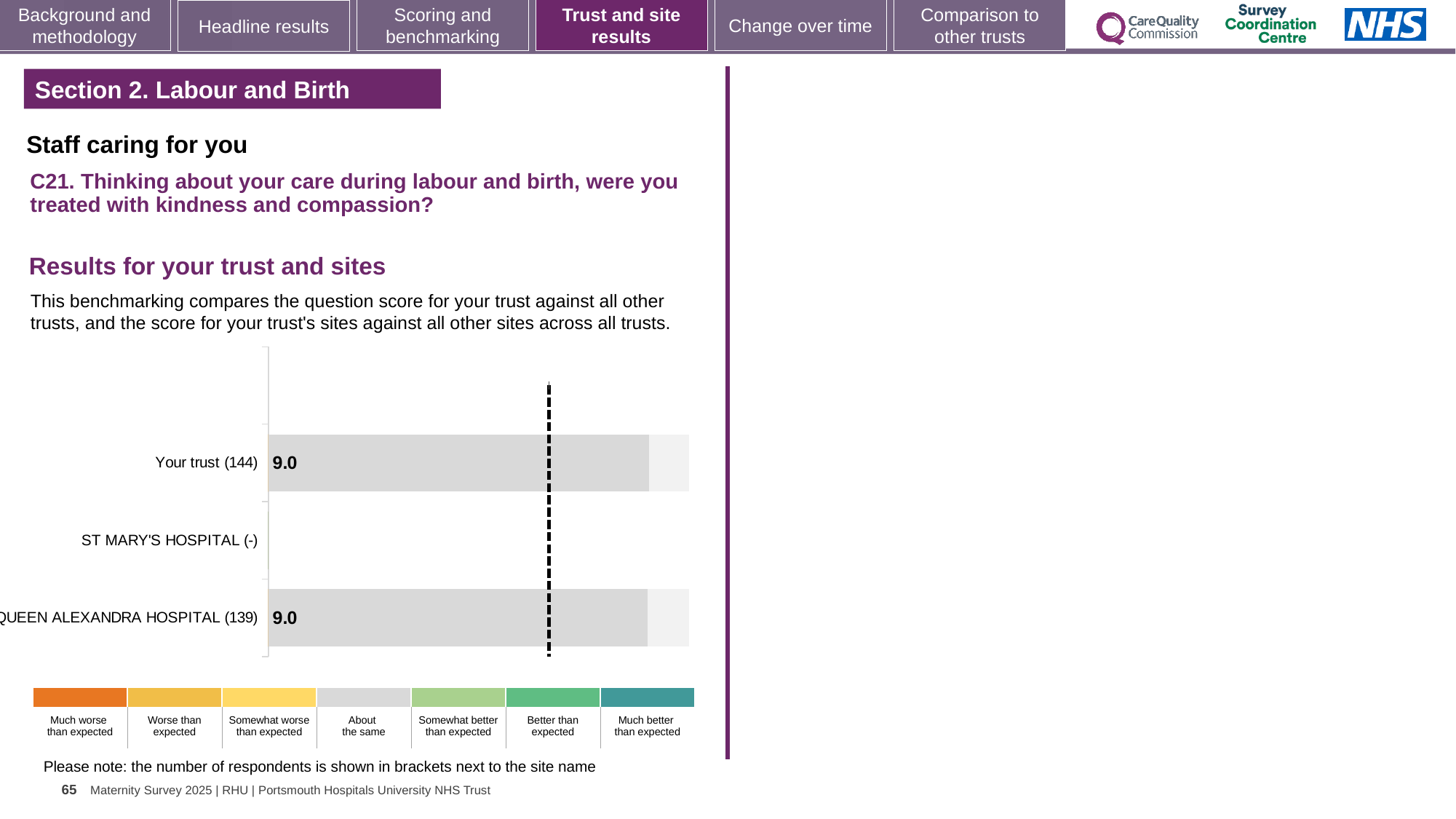
How many respondents are shown in brackets for Your trust? 144 What is the score shown for QUEEN ALEXANDRA HOSPITAL? 9.0 How many colour bands are shown in the key below the chart? 7 How many respondents are shown in brackets for QUEEN ALEXANDRA HOSPITAL? 139 What is the difference between the score for Your trust and the score for QUEEN ALEXANDRA HOSPITAL? 0.0 What kind of chart is shown on the slide? Bar chart How many categories (rows) are listed on the chart? 3 Which site on the chart has no score bar displayed? ST MARY'S HOSPITAL What is the score shown for Your trust? 9.0